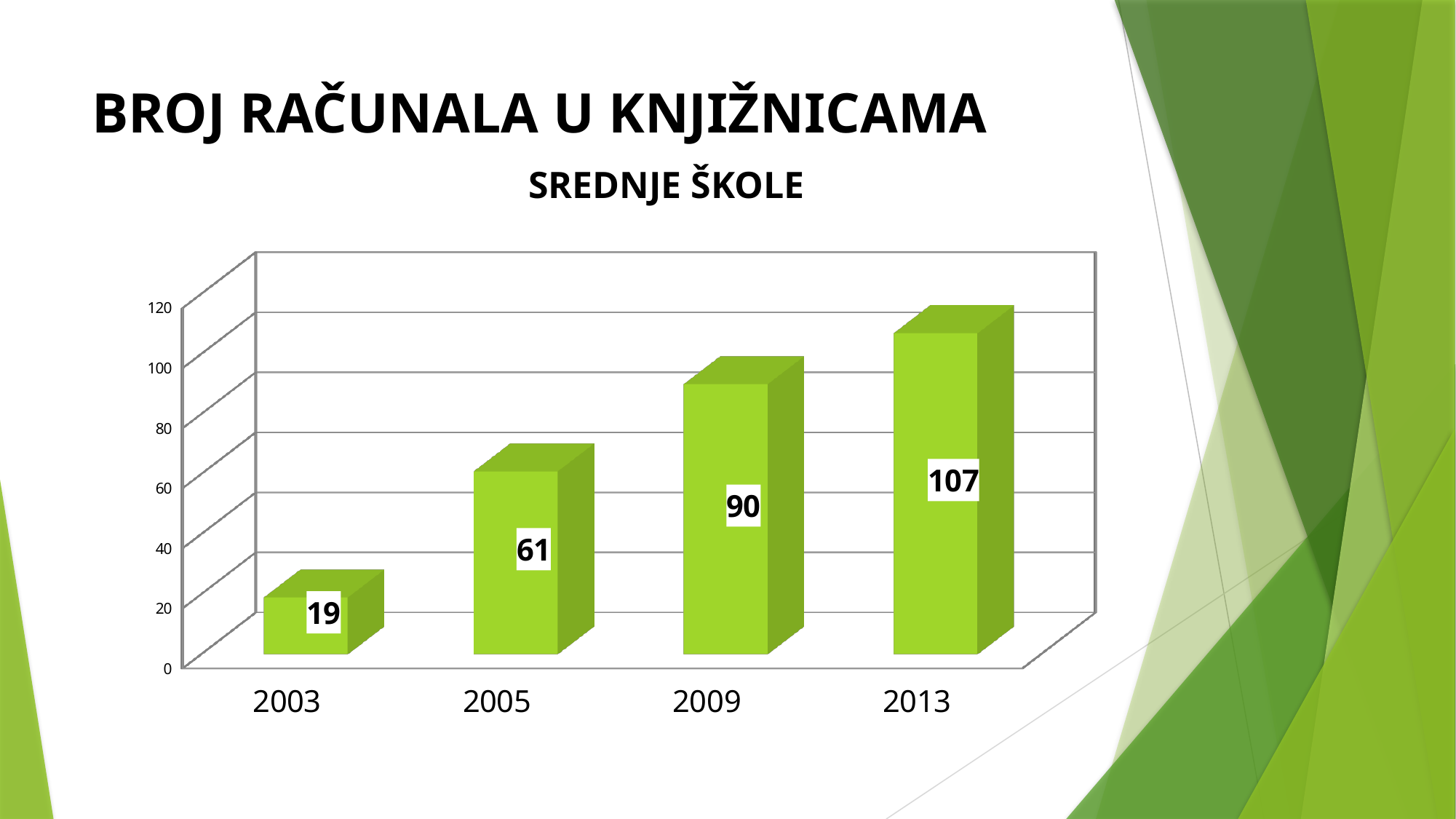
What is the value for 2005? 61 What kind of chart is shown on the slide? bar chart Which year has the lowest value? 2003 What is the difference between the values for 2009 and 2005? 29 Do the values rise or fall from 2003 to 2013? rise Which year has the highest value? 2013 Which is larger, the value for 2005 or the value for 2009? 2009 What is the difference between the values for 2013 and 2003? 88 What is the value for 2013? 107 What is the value for 2003? 19 What is the value for 2009? 90 How many years are shown on the chart? 4